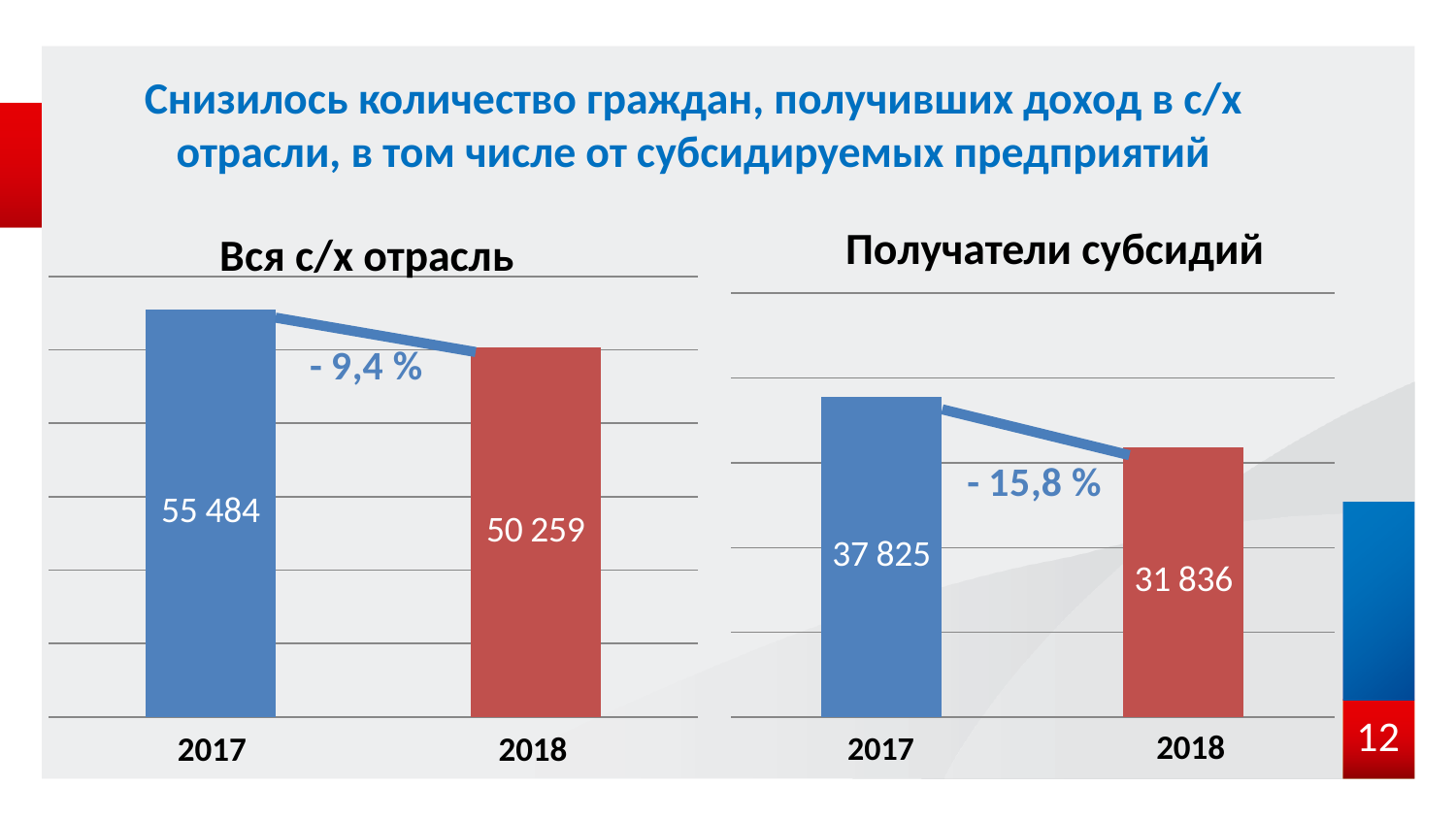
In the chart titled "Получатели субсидий", what is the difference between the 2017 and 2018 values? 5 989 In the chart titled "Вся с/х отрасль", what percentage change is shown between 2017 and 2018? - 9,4 % In the chart titled "Вся с/х отрасль", what is the value for 2018? 50 259 In the chart titled "Получатели субсидий", what is the value for 2018? 31 836 In the chart titled "Вся с/х отрасль", which year has the higher value? 2017 In the chart titled "Вся с/х отрасль", what is the value for 2017? 55 484 In the chart titled "Получатели субсидий", what percentage change is shown between 2017 and 2018? - 15,8 % In the chart titled "Получатели субсидий", do the values rise or fall from 2017 to 2018? fall What kind of chart is the chart titled "Вся с/х отрасль"? bar chart In the chart titled "Получатели субсидий", what is the value for 2017? 37 825 In the chart titled "Вся с/х отрасль", what is the difference between the 2017 and 2018 values? 5 225 In the chart titled "Получатели субсидий", which year has the lower value? 2018